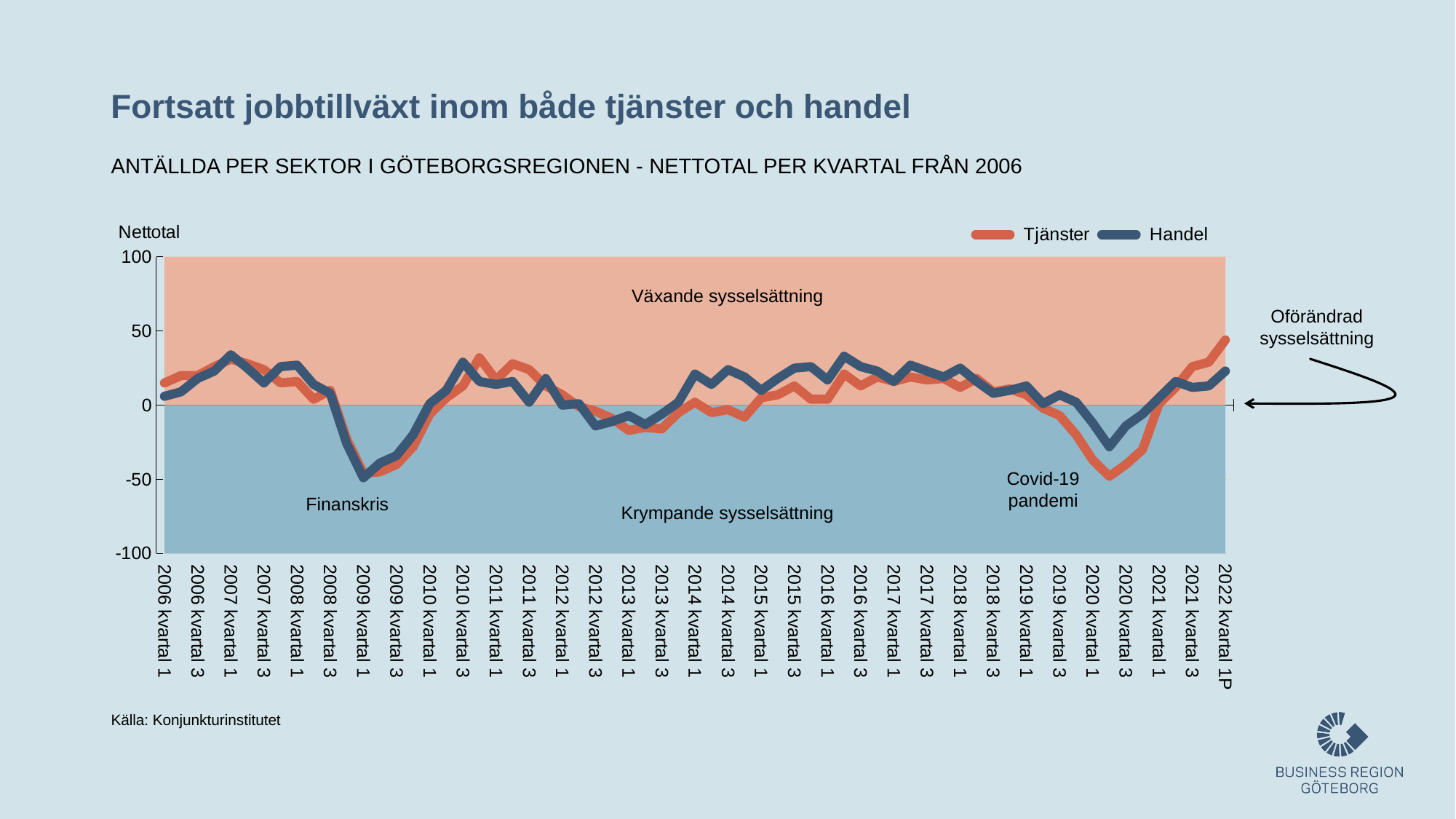
What is the label of the vertical axis? Nettotal At 2022 kvartal 1P, which series has the higher value, Tjänster or Handel? Tjänster What kind of chart is shown on the slide? Line chart Which two series are listed in the chart legend? Tjänster and Handel Is the value for Handel at 2020 kvartal 3 greater or less than -50? greater At 2020 kvartal 3, which series has the higher value, Tjänster or Handel? Handel Do the values for Tjänster rise or fall from 2020 kvartal 3 to 2022 kvartal 1P? Rise Is the value for Handel at 2020 kvartal 3 greater or less than 0? less Is the value for Tjänster at 2022 kvartal 1P greater or less than 50? less How many series does the legend list? 2